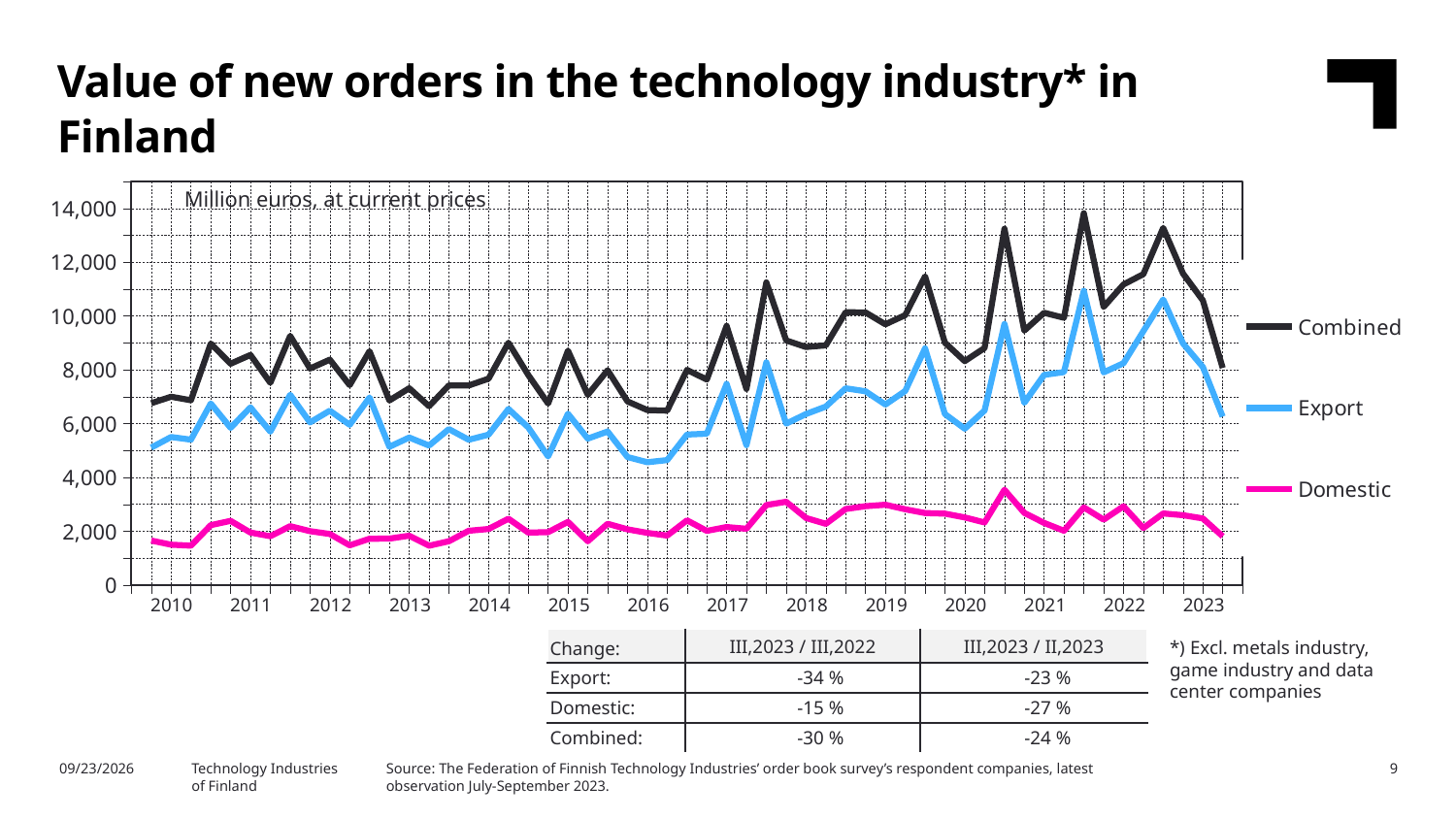
Does the Combined series rise or fall from its 2022 peak to the last observation in 2023? fall Is the peak Combined value in 2021 greater or less than 12,000? greater How many year labels are shown on the x axis? 14 Is the Export value at the start of 2016 greater or less than 6,000? less Which series has the highest values throughout the chart? Combined Is the Domestic value in 2020 greater or less than 4,000? less In 2018, which is larger, the Combined value or the Domestic value? Combined Which series is plotted in pink? Domestic What kind of chart is shown on the slide? line chart Which series has the lowest values throughout the chart? Domestic How many series does the legend list? 3 What unit is stated for the values in the chart? Million euros, at current prices